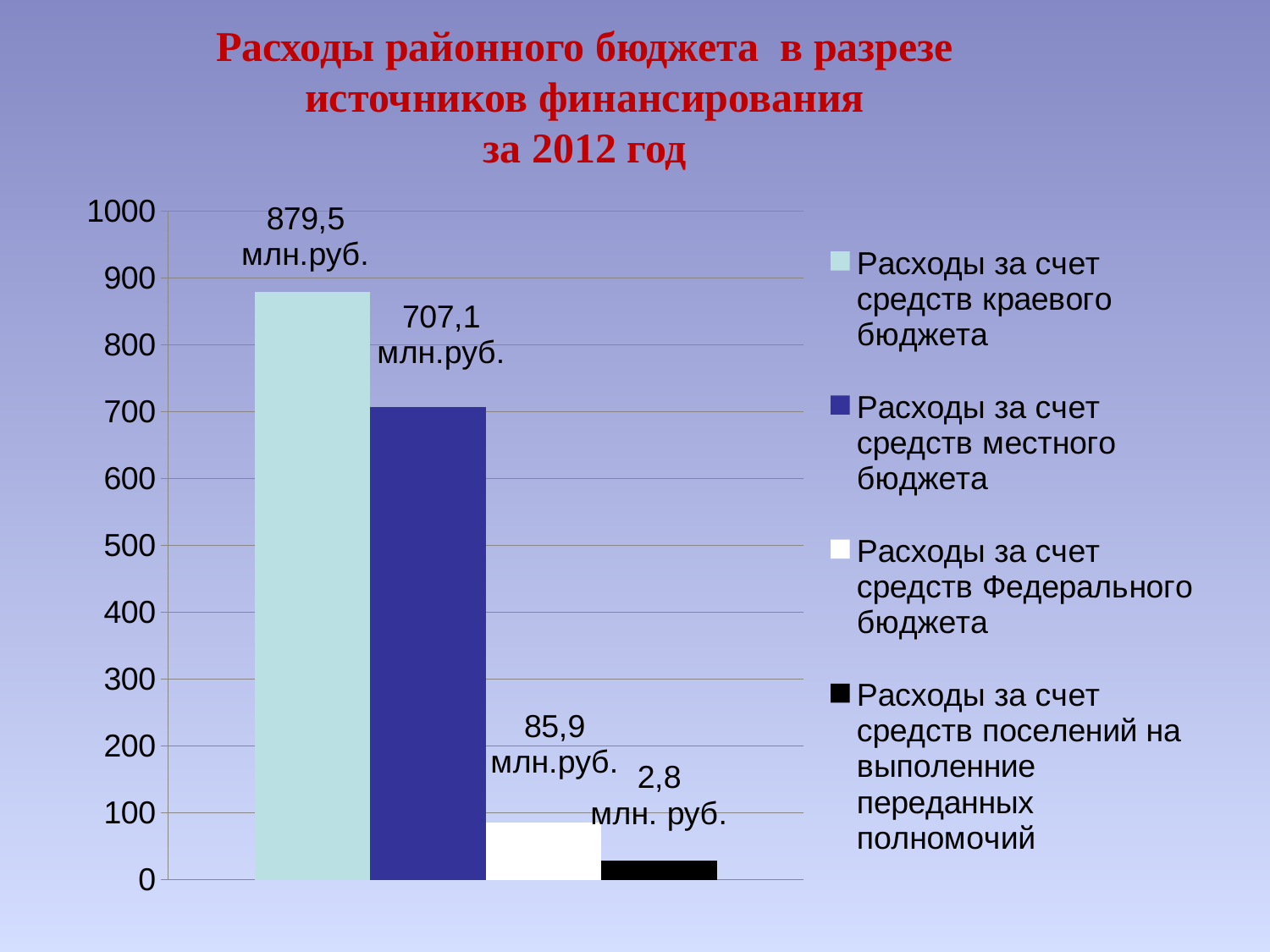
What is the value for «Расходы за счет средств местного бюджета»? 707,1 млн.руб. What colour is the bar for «Расходы за счет средств местного бюджета»? Dark blue Is the value for «Расходы за счет средств местного бюджета» greater or less than 800? less Which is larger: expenditures from the Федеральный бюджет or from the местный бюджет? Расходы за счет средств местного бюджета How many series does the legend list? 4 What kind of chart is shown on the slide? Bar chart Which funding source has the lowest expenditure? Расходы за счет средств поселений на выполенние переданных полномочий What is the value for «Расходы за счет средств поселений на выполенние переданных полномочий»? 2,8 млн. руб. Which funding source has the highest expenditure? Расходы за счет средств краевого бюджета What is the difference between expenditures from the краевой бюджет and the местный бюджет? 172,4 млн.руб. What is the value for «Расходы за счет средств краевого бюджета»? 879,5 млн.руб. What is the value for «Расходы за счет средств Федерального бюджета»? 85,9 млн.руб.